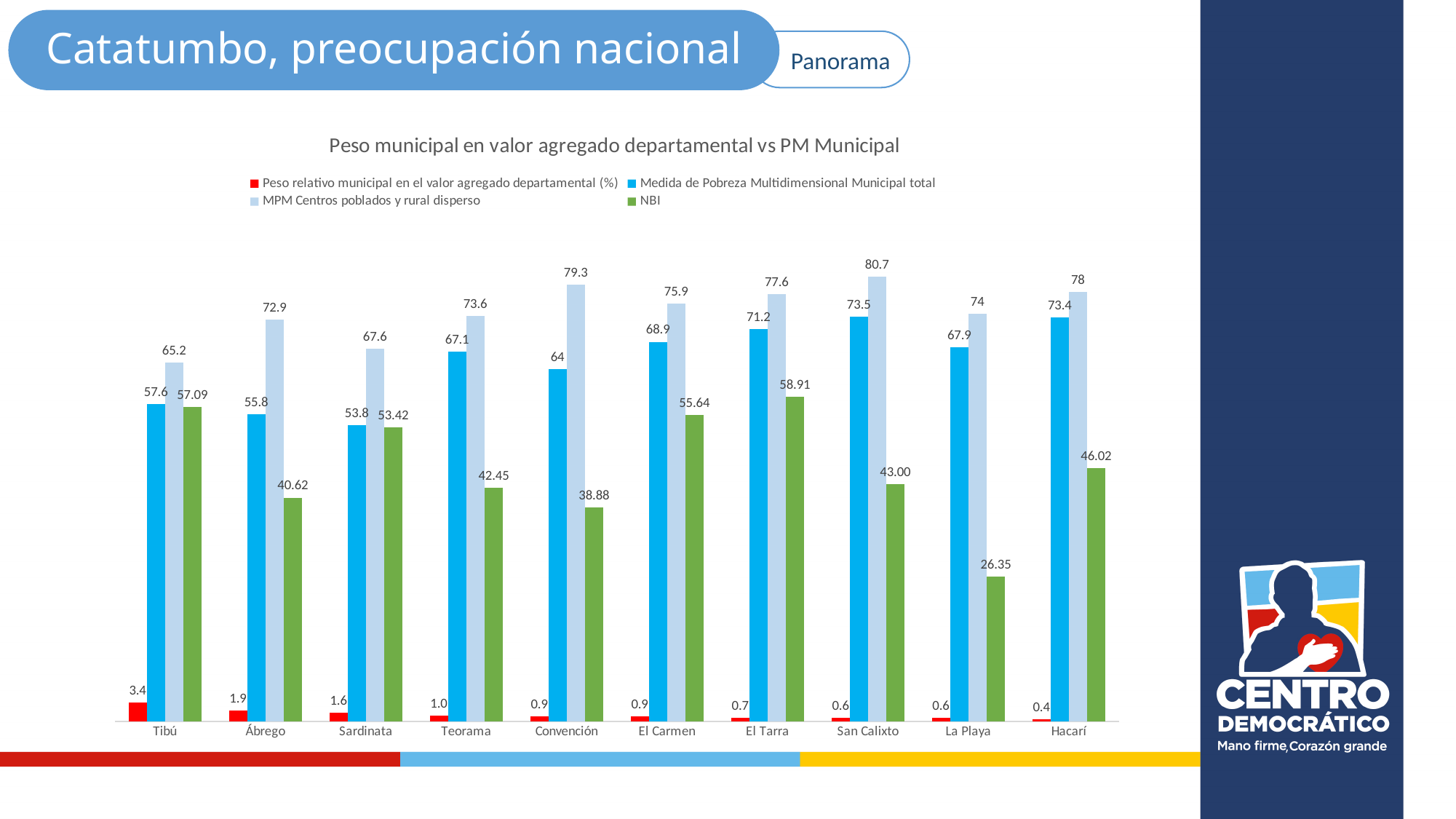
What is the NBI value for La Playa? 26.35 Which municipality has the lowest NBI value? La Playa What kind of chart is shown on the slide? Bar chart Does the Peso relativo municipal en el valor agregado departamental (%) rise or fall from Tibú to Hacarí along the x axis? Fall Which municipality has the highest Peso relativo municipal en el valor agregado departamental (%)? Tibú For San Calixto, what is the difference between MPM Centros poblados y rural disperso and NBI? 37.7 What is the value of MPM Centros poblados y rural disperso for San Calixto? 80.7 How many series does the legend list? 4 Which municipality has the highest value for MPM Centros poblados y rural disperso? San Calixto Which is larger: the Medida de Pobreza Multidimensional Municipal total for El Tarra or for Hacarí? Hacarí How many municipalities are shown on the x axis? 10 What is the Medida de Pobreza Multidimensional Municipal total for Convención? 64